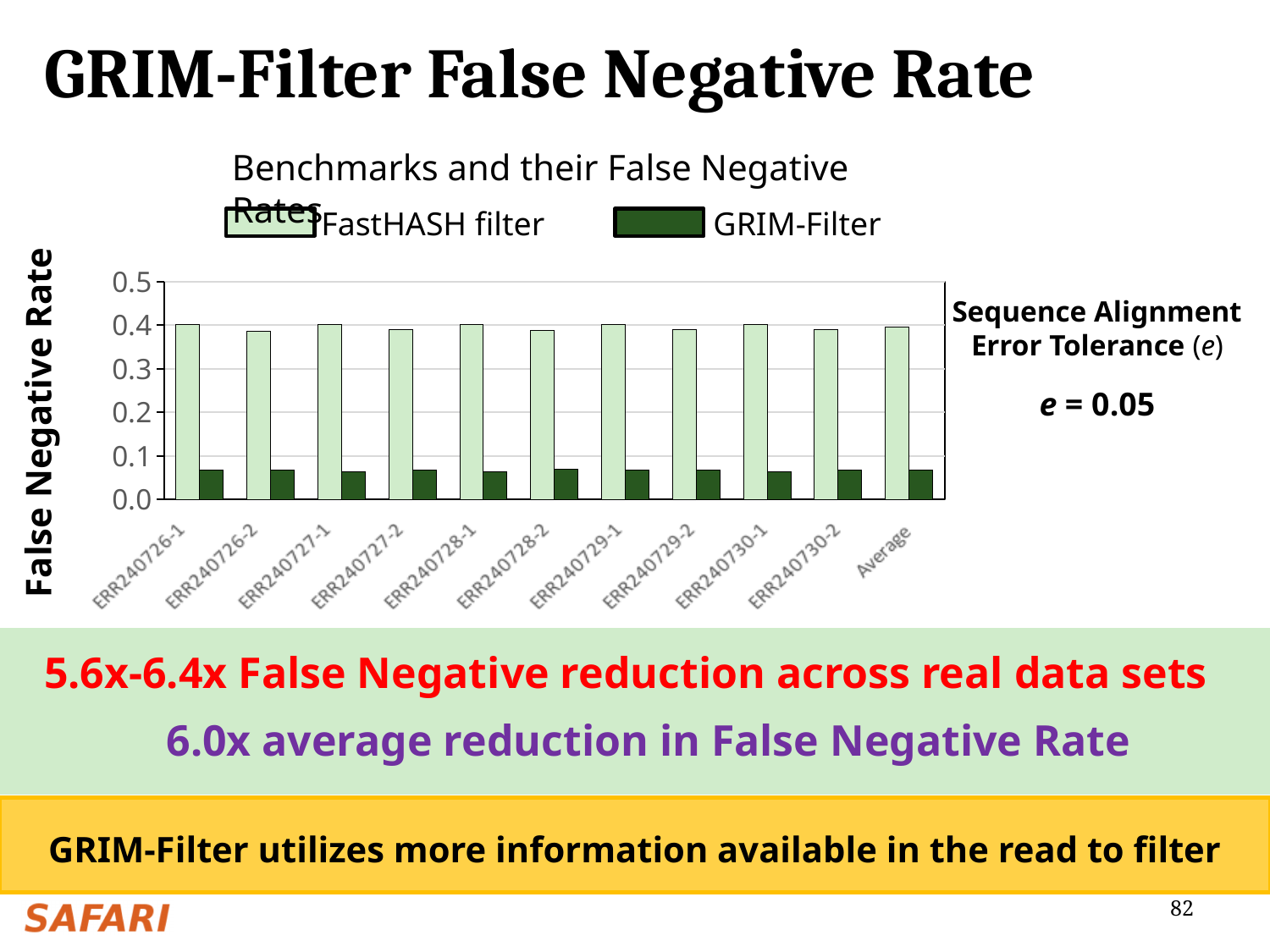
For ERR240729-1, which series has the larger value, FastHASH filter or GRIM-Filter? FastHASH filter Is the FastHASH filter value for ERR240726-1 greater or less than 0.3? greater For Average, which series has the smaller value, FastHASH filter or GRIM-Filter? GRIM-Filter What kind of chart is shown on the slide? bar chart Is the FastHASH filter value for ERR240727-2 greater or less than 0.2? greater How many categories are shown along the x axis of the chart? 11 Is the GRIM-Filter value for ERR240728-1 greater or less than 0.2? less Which two series are listed in the chart's legend? FastHASH filter and GRIM-Filter How many series does the chart's legend list? 2 What is the label on the chart's vertical axis? False Negative Rate